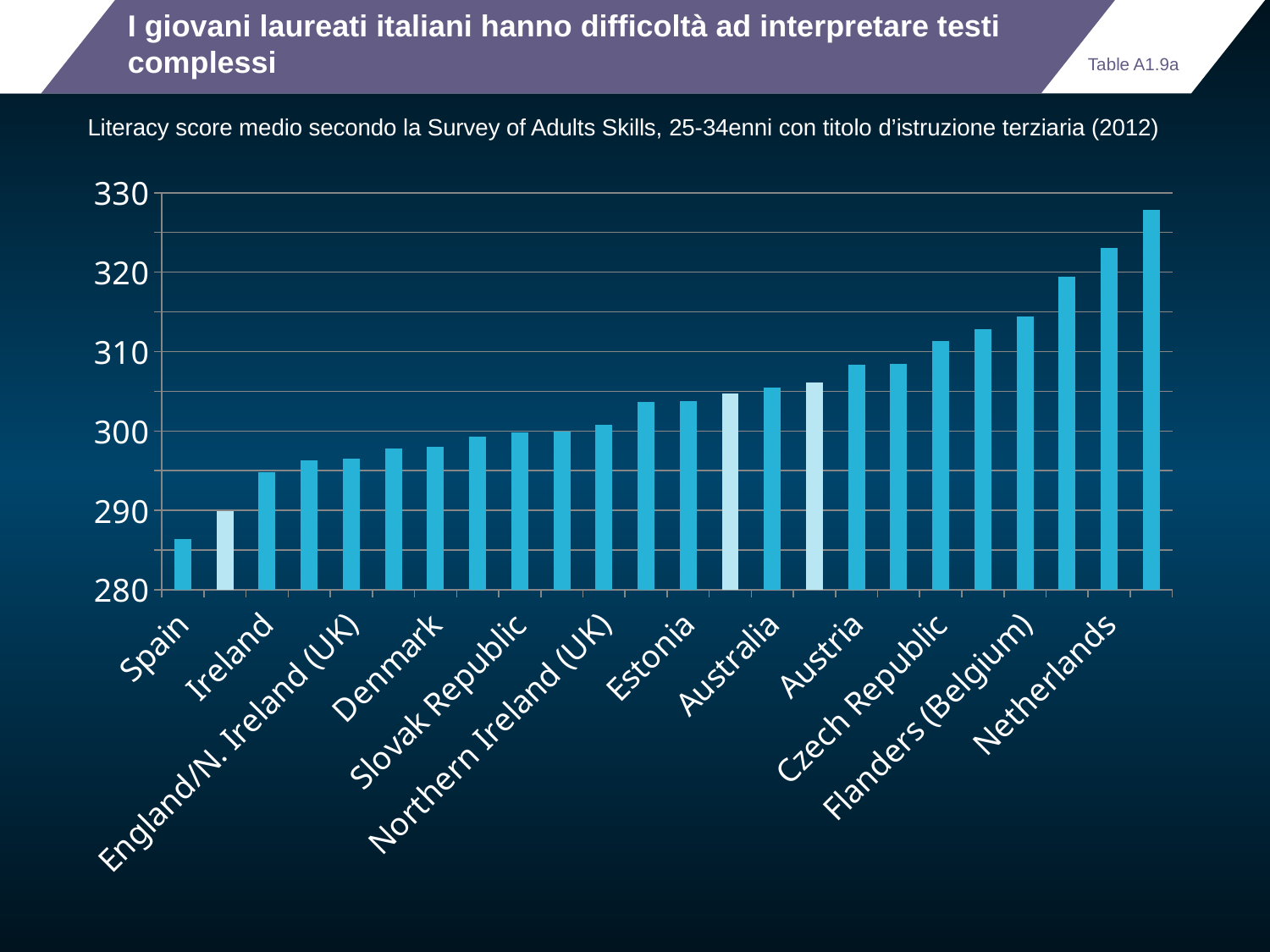
Which labelled country has the lowest literacy score in the chart? Spain Is the value for Ireland greater or less than 300? less What is the lowest value shown on the vertical axis? 280 Is the value for Spain greater or less than 290? less Is the value for Netherlands greater or less than 320? greater Which has the larger value, Spain or Netherlands? Netherlands Which has the larger value, Estonia or Czech Republic? Czech Republic What kind of chart is shown on the slide? bar chart Do the bar values rise or fall from left to right along the x axis? rise